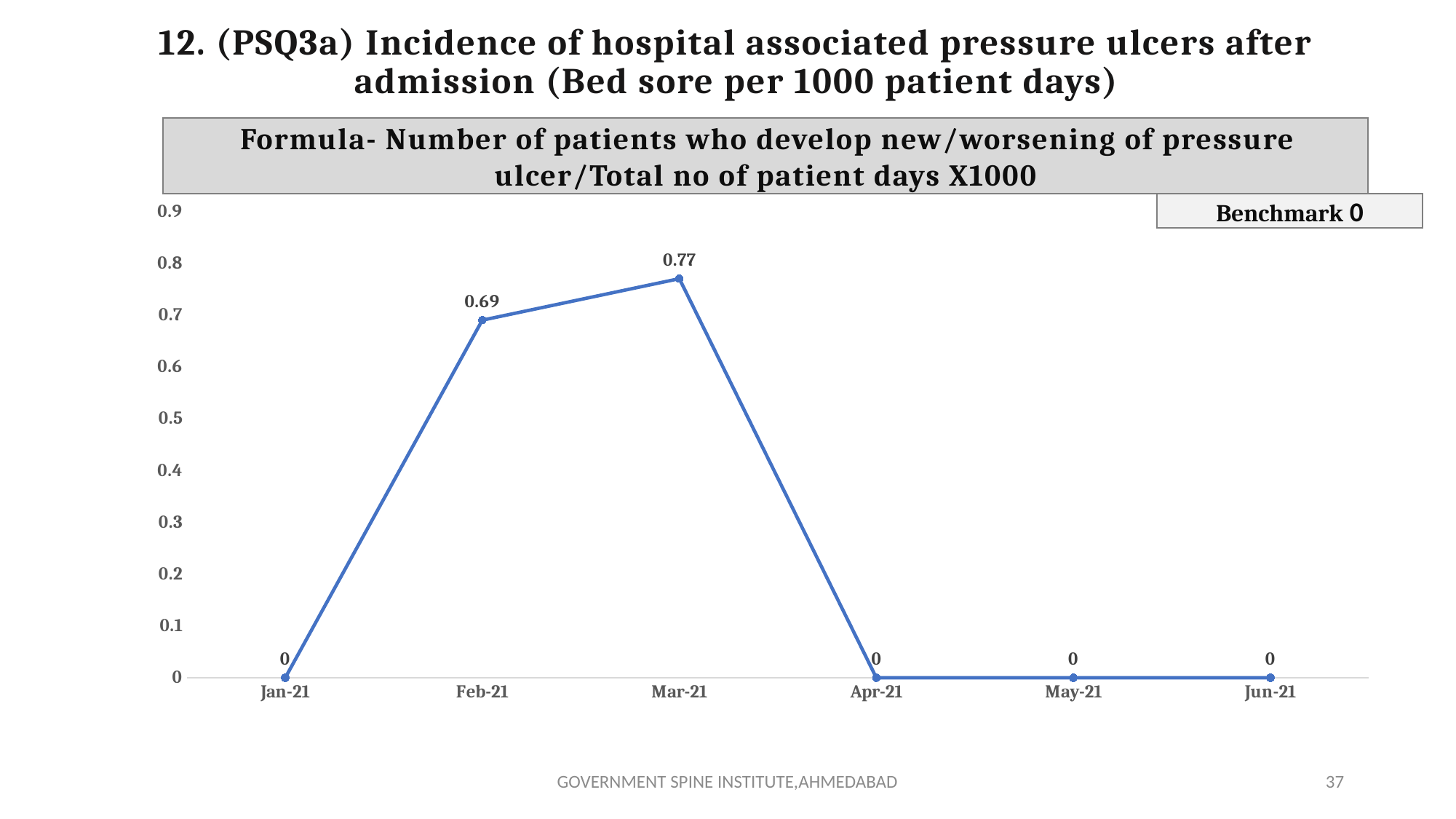
What is the value for Jan-21? 0 How many months are plotted on the x axis? 6 What benchmark value is shown on the slide? 0 Do the values rise or fall from Mar-21 to Apr-21? fall What is the value for Mar-21? 0.77 How many months have a value of 0? 4 Which is larger, the value for Feb-21 or the value for Mar-21? Mar-21 What is the value for Feb-21? 0.69 What kind of chart is shown on the slide? line chart What is the difference between the values for Mar-21 and Feb-21? 0.08 Which month has the highest value? Mar-21 Is the value for Feb-21 greater or less than 0.5? greater